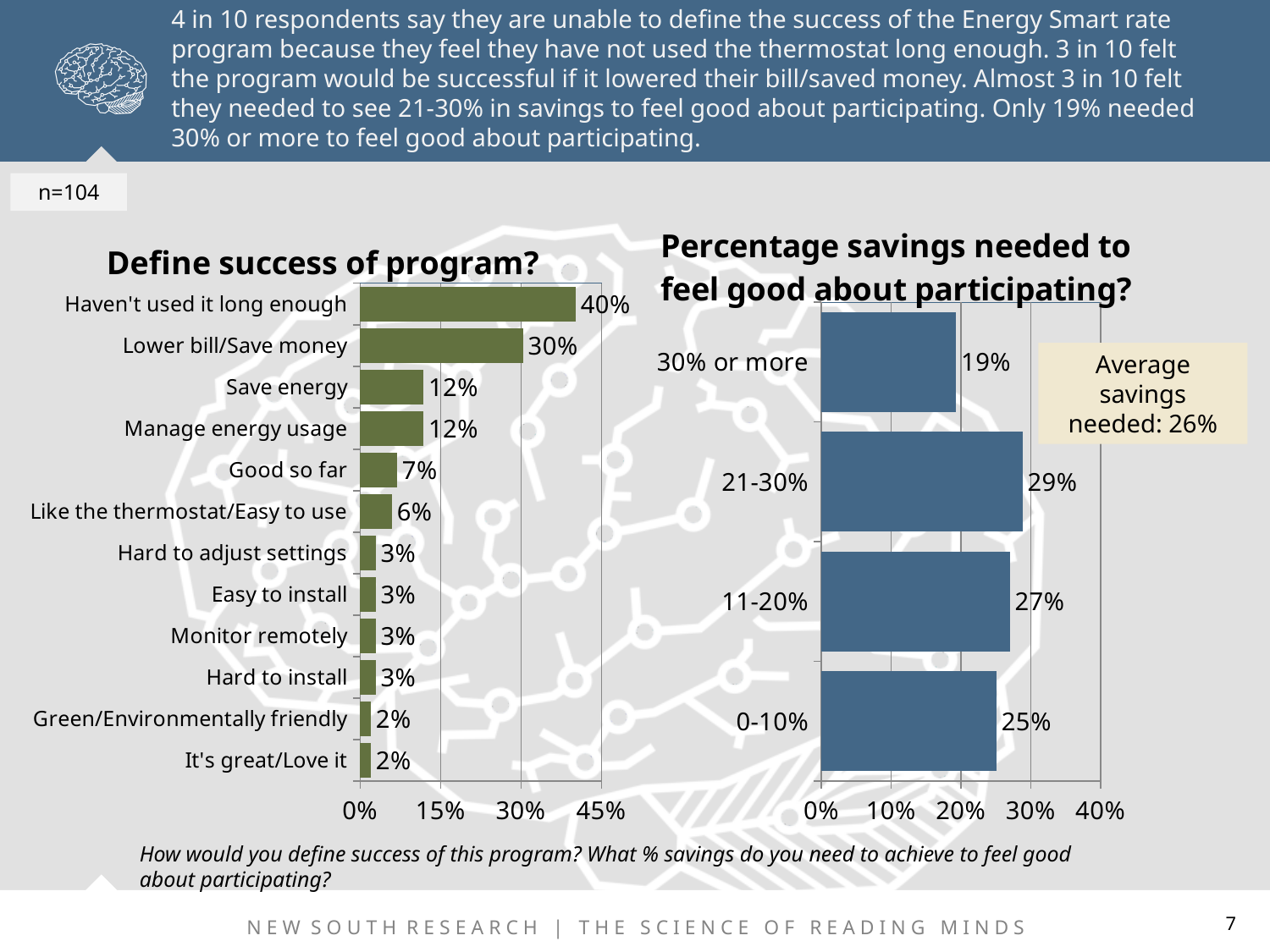
In the 'Percentage savings needed to feel good about participating?' chart, what is the value for '0-10%'? 25% In the 'Define success of program?' chart, what is the difference between 'Haven't used it long enough' and 'Lower bill/Save money'? 10% In the 'Define success of program?' chart, which is larger: 'Save energy' or 'Like the thermostat/Easy to use'? Save energy In the 'Percentage savings needed to feel good about participating?' chart, which category has the lowest value? 30% or more In the 'Define success of program?' chart, which category has the highest value? Haven't used it long enough In the 'Percentage savings needed to feel good about participating?' chart, what is the value for '21-30%'? 29% In the 'Define success of program?' chart, what is the value for 'Haven't used it long enough'? 40% In the 'Define success of program?' chart, how many categories are shown? 12 According to the callout on the 'Percentage savings needed to feel good about participating?' chart, what is the average savings needed? 26% In the 'Percentage savings needed to feel good about participating?' chart, what is the difference between '21-30%' and '30% or more'? 10% In the 'Define success of program?' chart, what is the value for 'Good so far'? 7% What kind of chart is the 'Define success of program?' chart? Bar chart